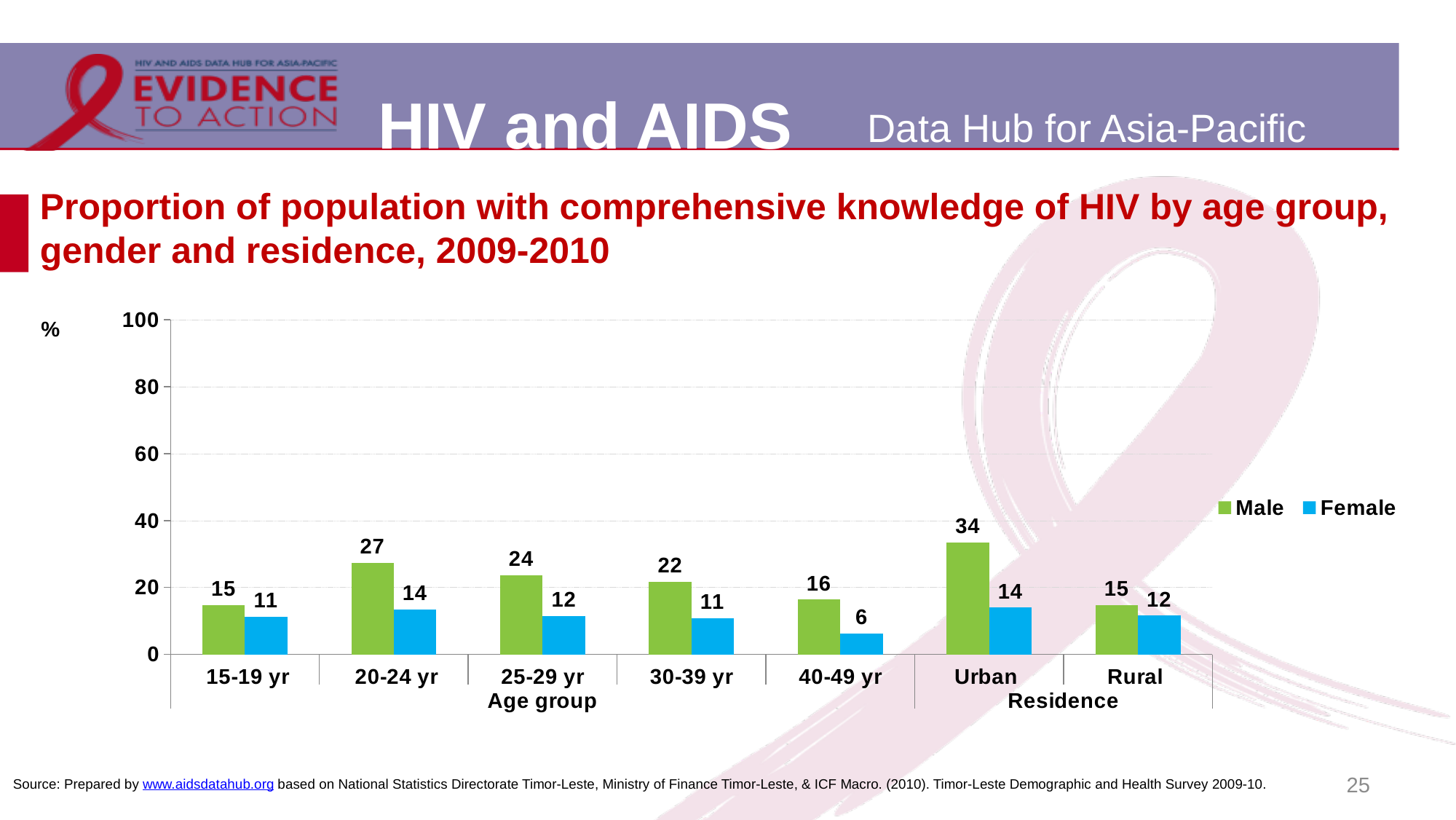
Which category has the lowest Female value? 40-49 yr Which is larger, the Male value for 25-29 yr or the Male value for 30-39 yr? 25-29 yr What is the Female value for the 40-49 yr age group? 6 Which colour represents the Female series? blue How many series does the legend list? 2 What kind of chart is shown on the slide? bar chart What is the difference between the Male and Female values for Urban residence? 20 Which category has the highest Male value? Urban How many categories are shown on the x axis? 7 Is the Male value for Urban greater or less than 40? less What is the Female value for Urban residence? 14 What is the Male value for the 20-24 yr age group? 27